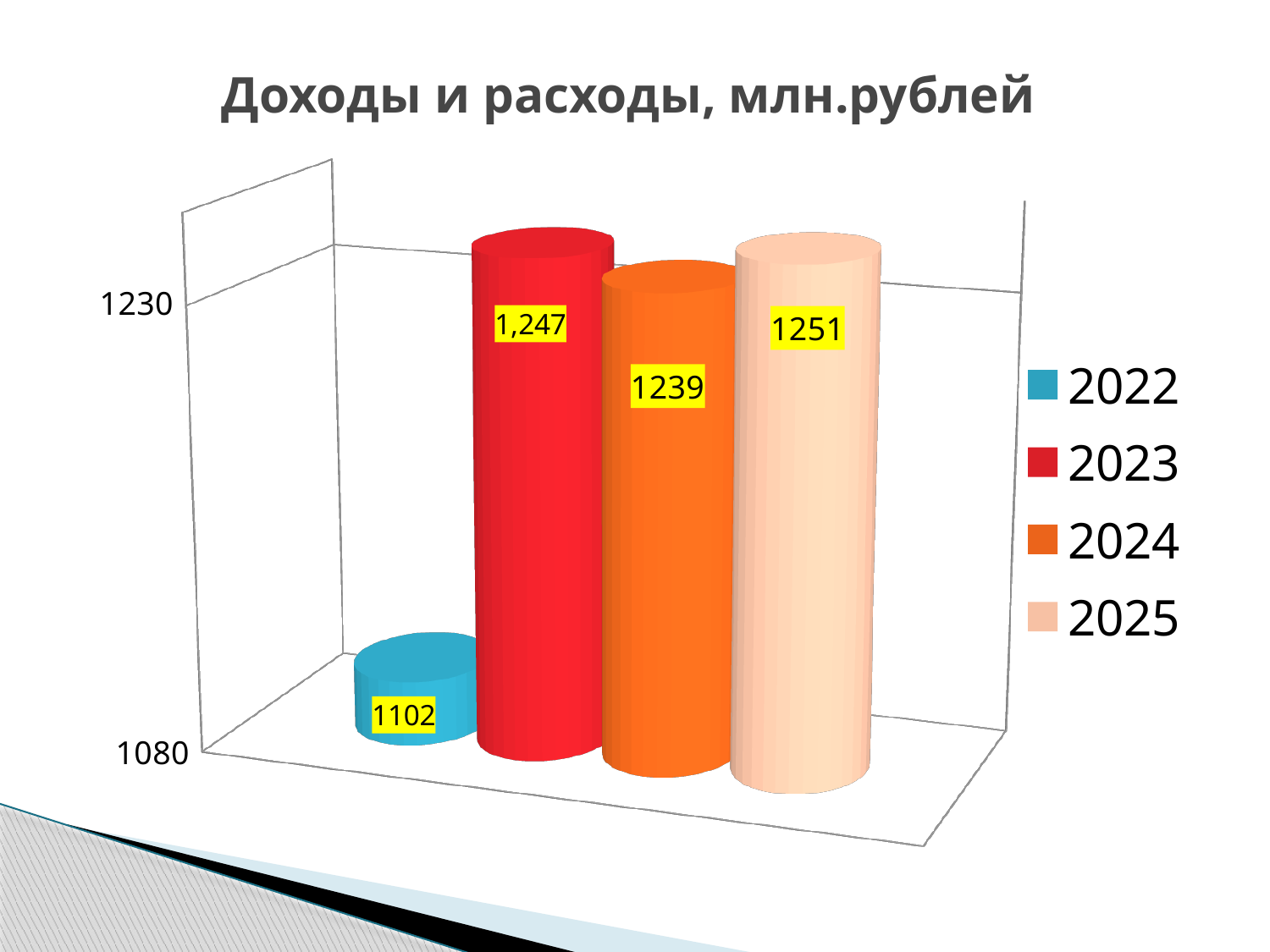
Which is larger, the value for 2023 or the value for 2024? 2023 What is the value shown for 2025? 1251 Is the value for 2022 greater or less than 1230? less Which year has the lowest value? 2022 What is the title of the chart? Доходы и расходы, млн.рублей How many bars are plotted on the chart? 4 What is the value shown for 2024? 1239 Which year has the highest value? 2025 What is the value shown for 2023? 1,247 What is the difference between the values for 2025 and 2022? 149 What is the value shown for 2022? 1102 How many entries does the legend list? 4